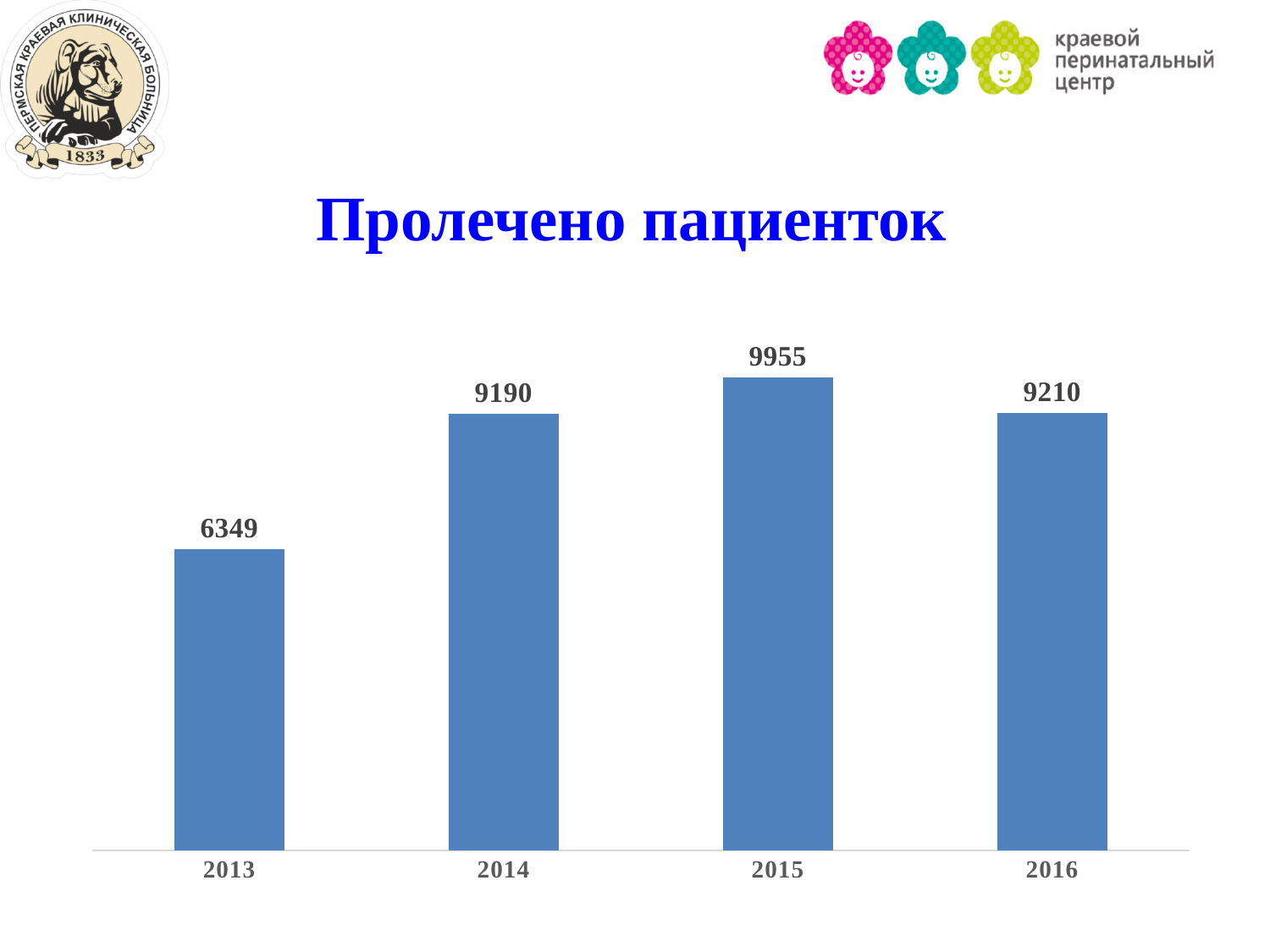
What is the difference between the values for 2015 and 2013? 3606 How many years are shown on the chart? 4 What is the value for 2016? 9210 Which year has the lowest value? 2013 What is the value for 2014? 9190 What is the value for 2013? 6349 Which is larger, the value for 2014 or the value for 2013? 2014 What kind of chart is this? bar chart What is the title of the chart? Пролечено пациенток What is the difference between the values for 2016 and 2014? 20 What is the value for 2015? 9955 Which year has the highest value? 2015